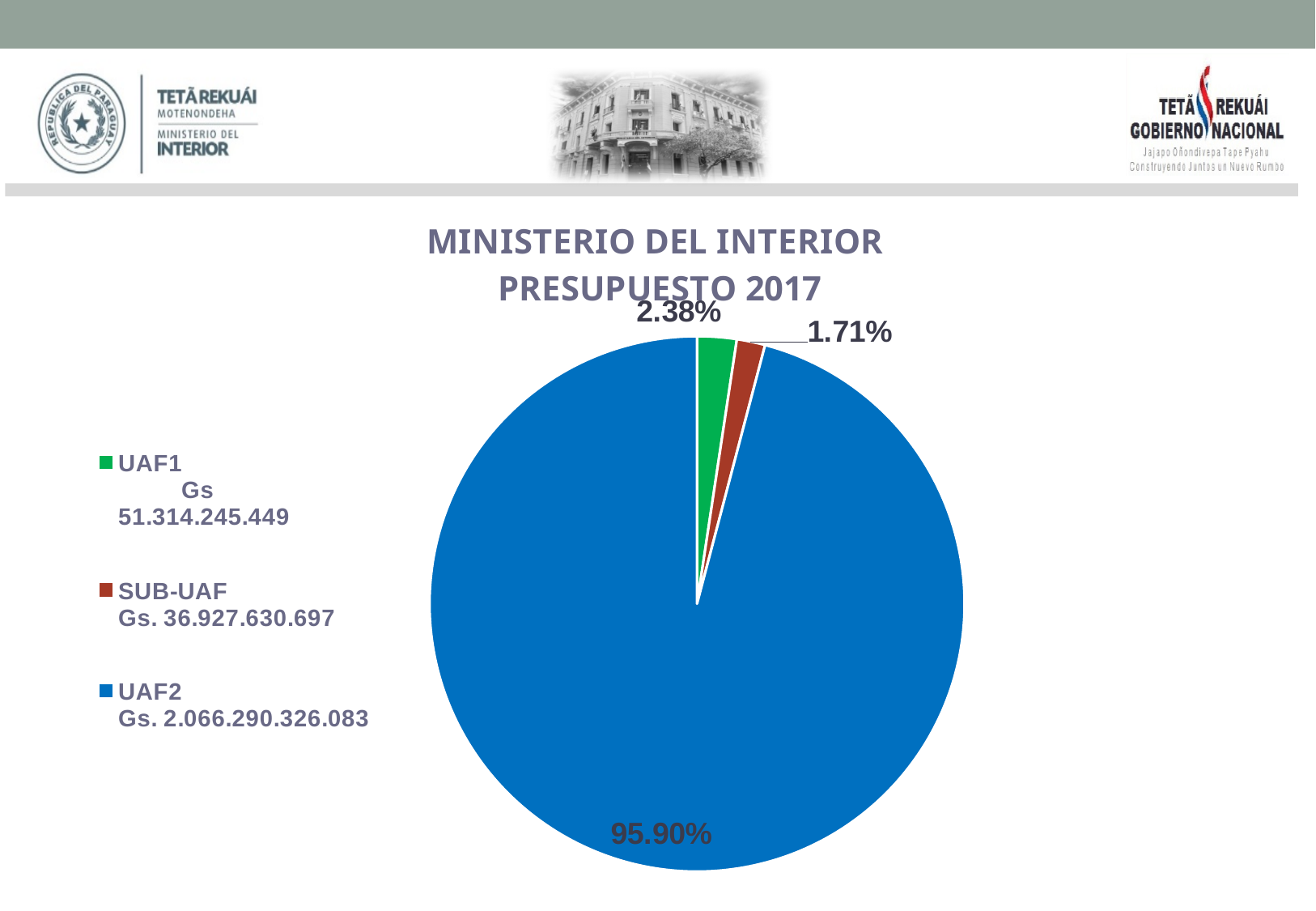
Which category has the smallest slice of the pie? SUB-UAF What is the title of the chart? MINISTERIO DEL INTERIOR PRESUPUESTO 2017 What percentage share of the pie does SUB-UAF hold? 1.71% Which is larger, the share for UAF1 or the share for SUB-UAF? UAF1 What colour is the slice for SUB-UAF? Red What is the difference in percentage points between the UAF1 share and the SUB-UAF share? 0.67 What percentage share of the pie does UAF2 hold? 95.90% Which category has the largest slice of the pie? UAF2 What percentage share of the pie does UAF1 hold? 2.38% How many slices does the pie chart have? 3 What amount in Gs is shown in the legend for UAF2? Gs. 2.066.290.326.083 What kind of chart is shown on the slide? Pie chart